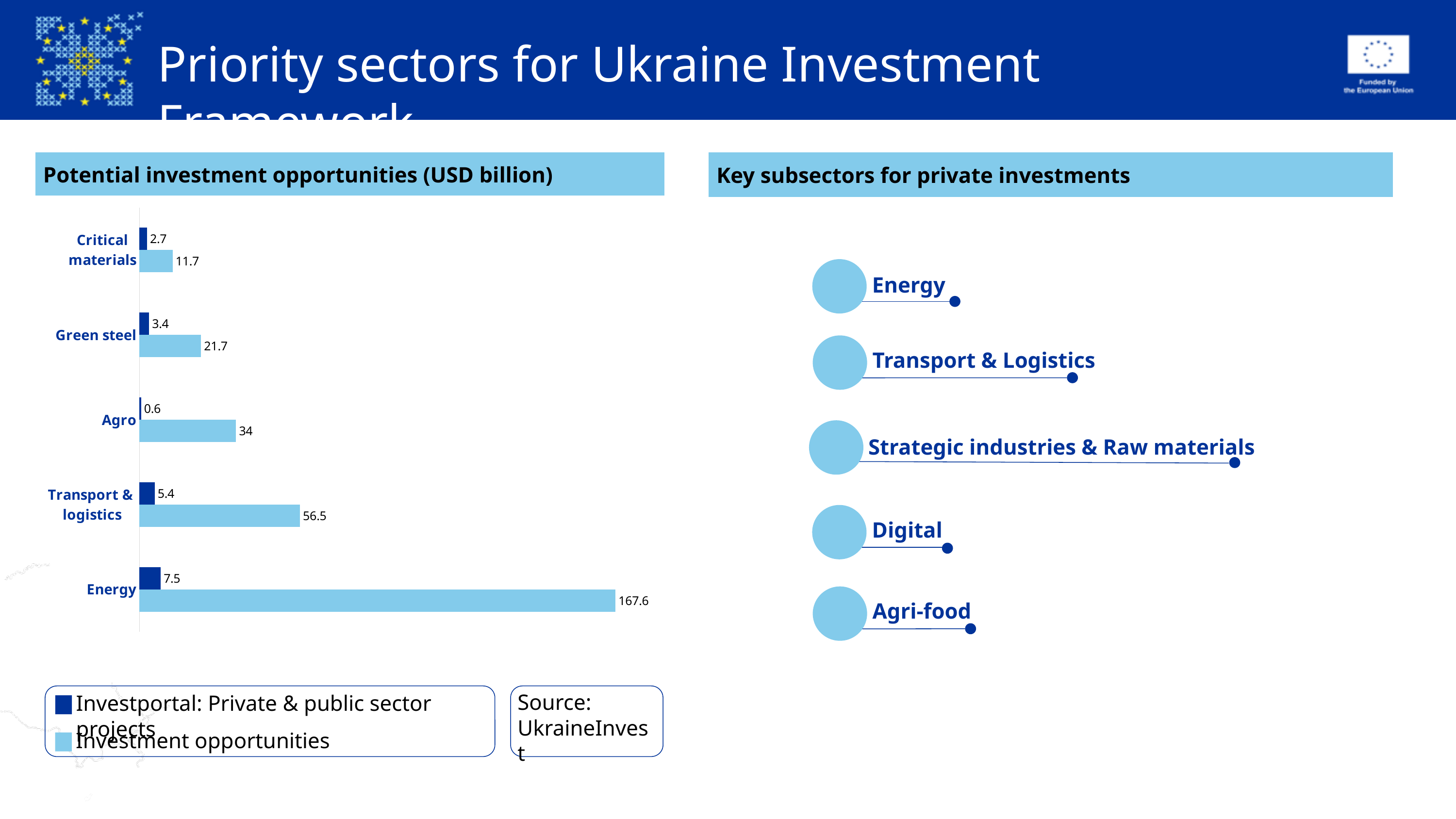
How many categories are shown in the chart? 5 What kind of chart is shown on the slide? Bar chart What is the difference between the Investment opportunities values for Transport & logistics and Green steel? 34.8 Which is larger, the Investment opportunities value for Green steel or for Critical materials? Green steel Which category has the highest Investment opportunities value? Energy What is the Investment opportunities value for Energy? 167.6 What is the Investment opportunities value for Agro? 34 What is the Investportal: Private & public sector projects value for Critical materials? 2.7 How many series does the legend list? 2 What is the Investportal: Private & public sector projects value for Transport & logistics? 5.4 Which category has the lowest Investportal: Private & public sector projects value? Agro What is the title of the chart? Potential investment opportunities (USD billion)